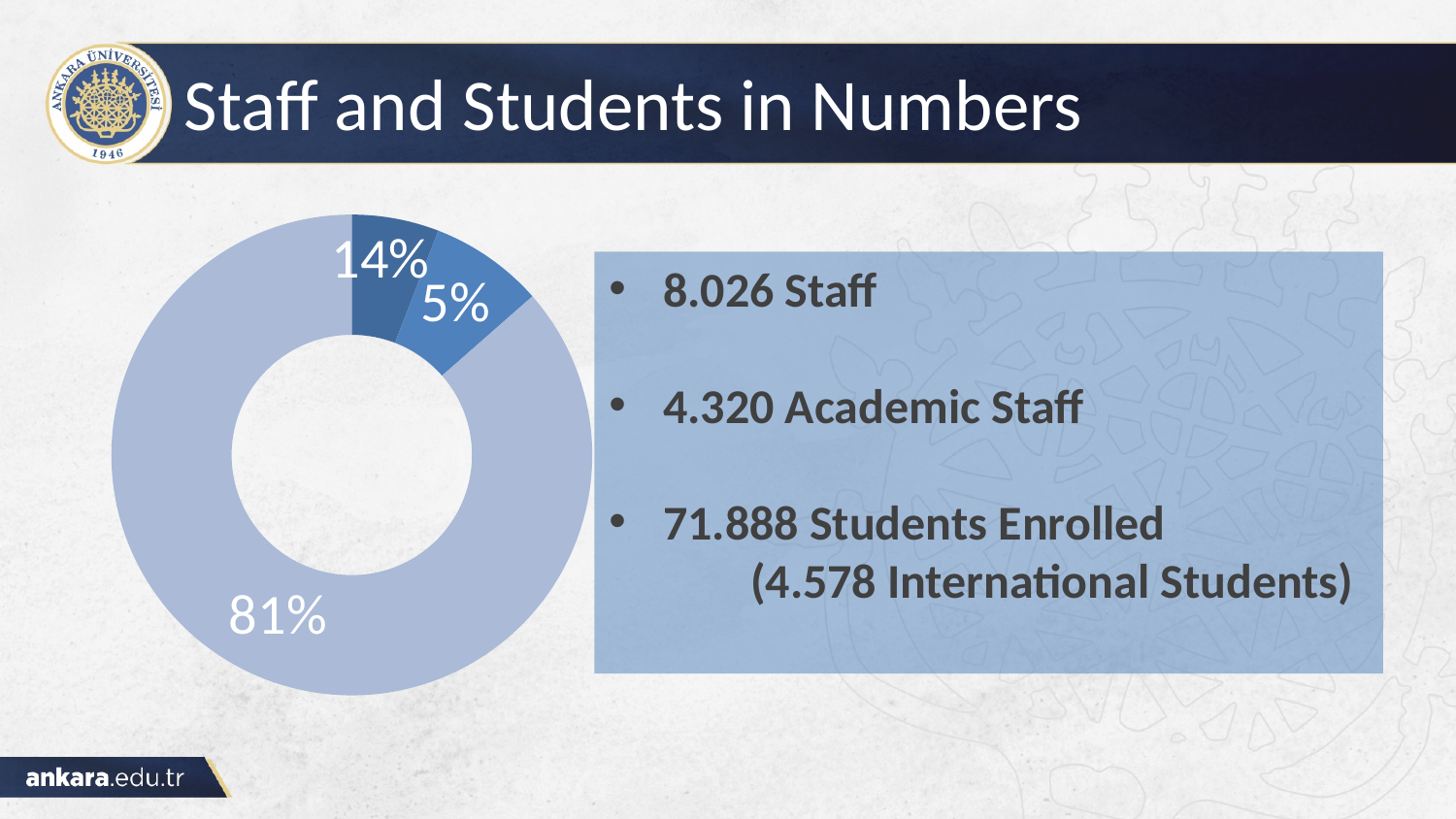
What kind of chart is shown on the slide? Doughnut chart What is the title of the slide containing the doughnut chart? Staff and Students in Numbers How many slices does the doughnut chart have? 3 What is the difference in percentage points between the 14% slice and the 5% slice? 9 Is the largest slice of the doughnut chart greater or less than 50%? greater What is the percentage shown on the largest slice of the doughnut chart? 81% What percentage is shown on the light blue slice of the doughnut chart? 81% What percentage is shown on the medium blue slice of the doughnut chart? 5% What percentage is shown on the dark blue slice of the doughnut chart? 14%